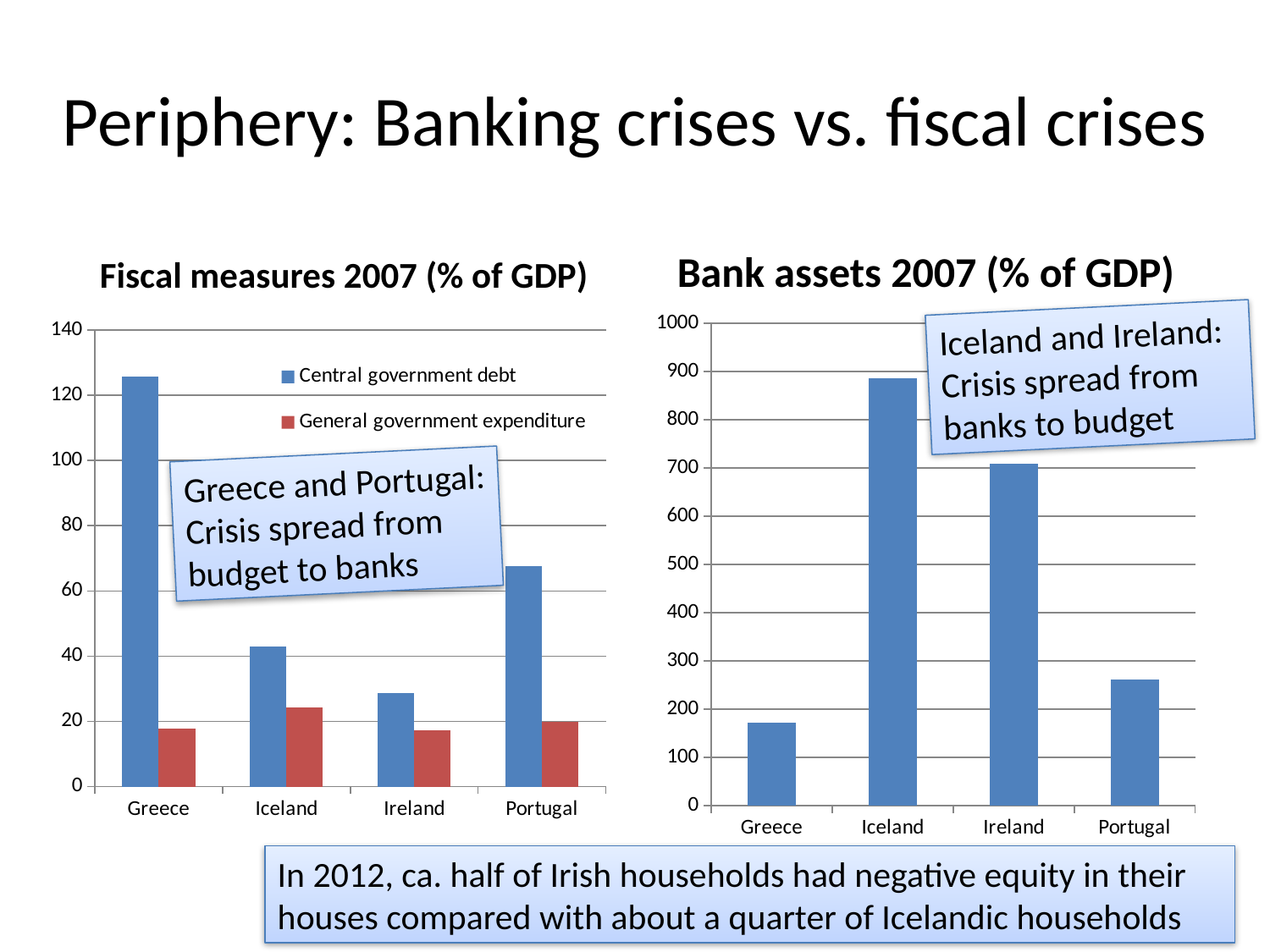
In the 'Bank assets 2007 (% of GDP)' chart, is the value for Portugal greater or less than 300? less In the 'Fiscal measures 2007 (% of GDP)' chart, is the central government debt for Greece greater or less than 120? greater In the 'Fiscal measures 2007 (% of GDP)' chart, which country has the highest central government debt? Greece In the 'Bank assets 2007 (% of GDP)' chart, which has larger bank assets, Ireland or Portugal? Ireland What kind of chart is the 'Bank assets 2007 (% of GDP)' chart? Bar chart In the 'Fiscal measures 2007 (% of GDP)' chart, which has higher general government expenditure, Iceland or Ireland? Iceland In the 'Bank assets 2007 (% of GDP)' chart, which country has the lowest bank assets? Greece How many countries are shown in the 'Bank assets 2007 (% of GDP)' chart? 4 In the 'Bank assets 2007 (% of GDP)' chart, which country has the highest bank assets? Iceland How many series does the legend of the 'Fiscal measures 2007 (% of GDP)' chart list? 2 In the 'Bank assets 2007 (% of GDP)' chart, is the value for Iceland greater or less than 800? greater In the 'Fiscal measures 2007 (% of GDP)' chart, which country has the lowest central government debt? Ireland